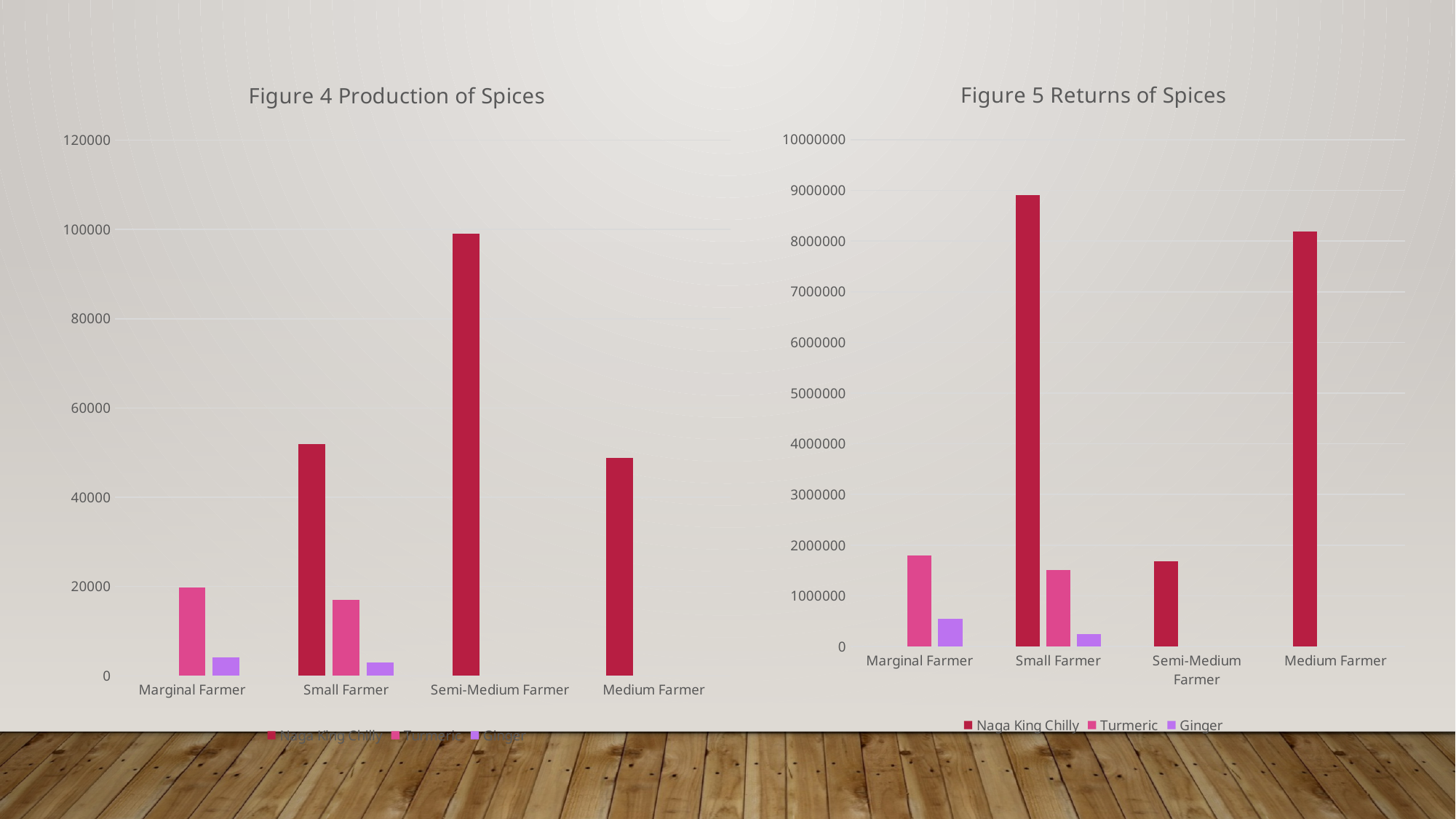
In the Figure 5 Returns of Spices chart, is the Naga King Chilly value for Medium Farmer greater or less than 7000000? greater In the Figure 5 Returns of Spices chart, is the Naga King Chilly value for Small Farmer greater or less than 8000000? greater In the Figure 5 Returns of Spices chart, which farmer category has the highest Naga King Chilly bar? Small Farmer In the Figure 4 Production of Spices chart, which farmer category has the highest Naga King Chilly bar? Semi-Medium Farmer In the Figure 4 Production of Spices chart, is the Naga King Chilly value for Semi-Medium Farmer greater or less than 80000? greater What kind of chart is the Figure 5 Returns of Spices chart? Bar chart In the Figure 5 Returns of Spices chart, which is larger for Marginal Farmer: Turmeric or Ginger? Turmeric In the Figure 4 Production of Spices chart, which is larger for Naga King Chilly: Semi-Medium Farmer or Medium Farmer? Semi-Medium Farmer How many series does the legend of the Figure 5 Returns of Spices chart list? 3 How many farmer categories are shown on the x axis of the Figure 4 Production of Spices chart? 4